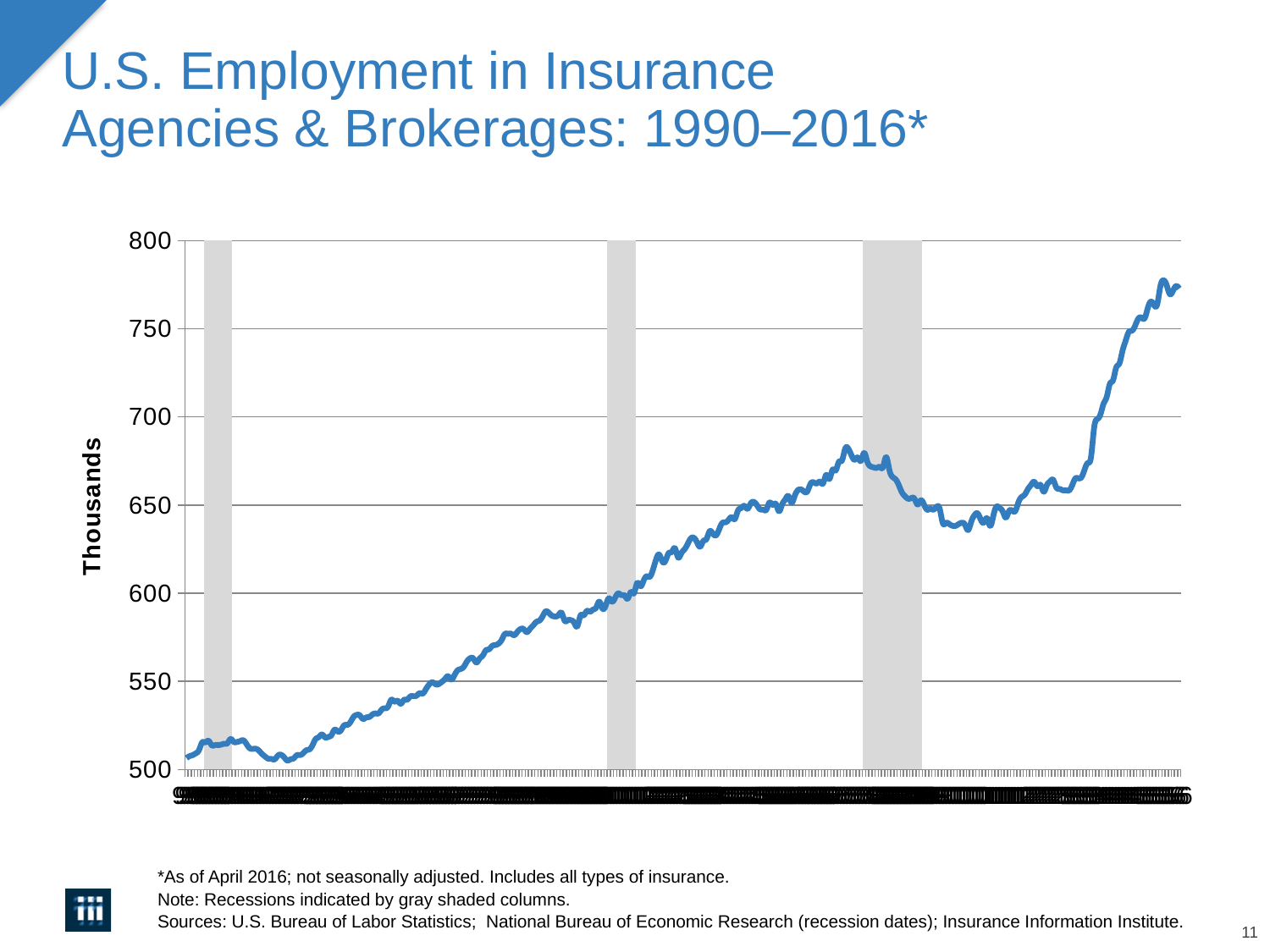
Is the value at the end of the series (April 2016) greater or less than 750? greater Is the value at the start of the series (1990) greater or less than 550? less Which is larger: the value at the end of the series in 2016 or the peak just before the third recession column? the value at the end of the series in 2016 What is the highest value shown on the vertical axis? 800 Overall, does employment rise or fall from the start of the series in 1990 to the end in 2016? rise How many gray shaded recession columns are shown on the chart? 3 What kind of chart is shown on the slide? line chart Is the peak reached just before the third gray recession column greater or less than 700? less Does the line rise or fall during the third gray recession column? fall What is the title of the chart on the slide? U.S. Employment in Insurance Agencies & Brokerages: 1990–2016* What is the label on the vertical axis of the chart? Thousands